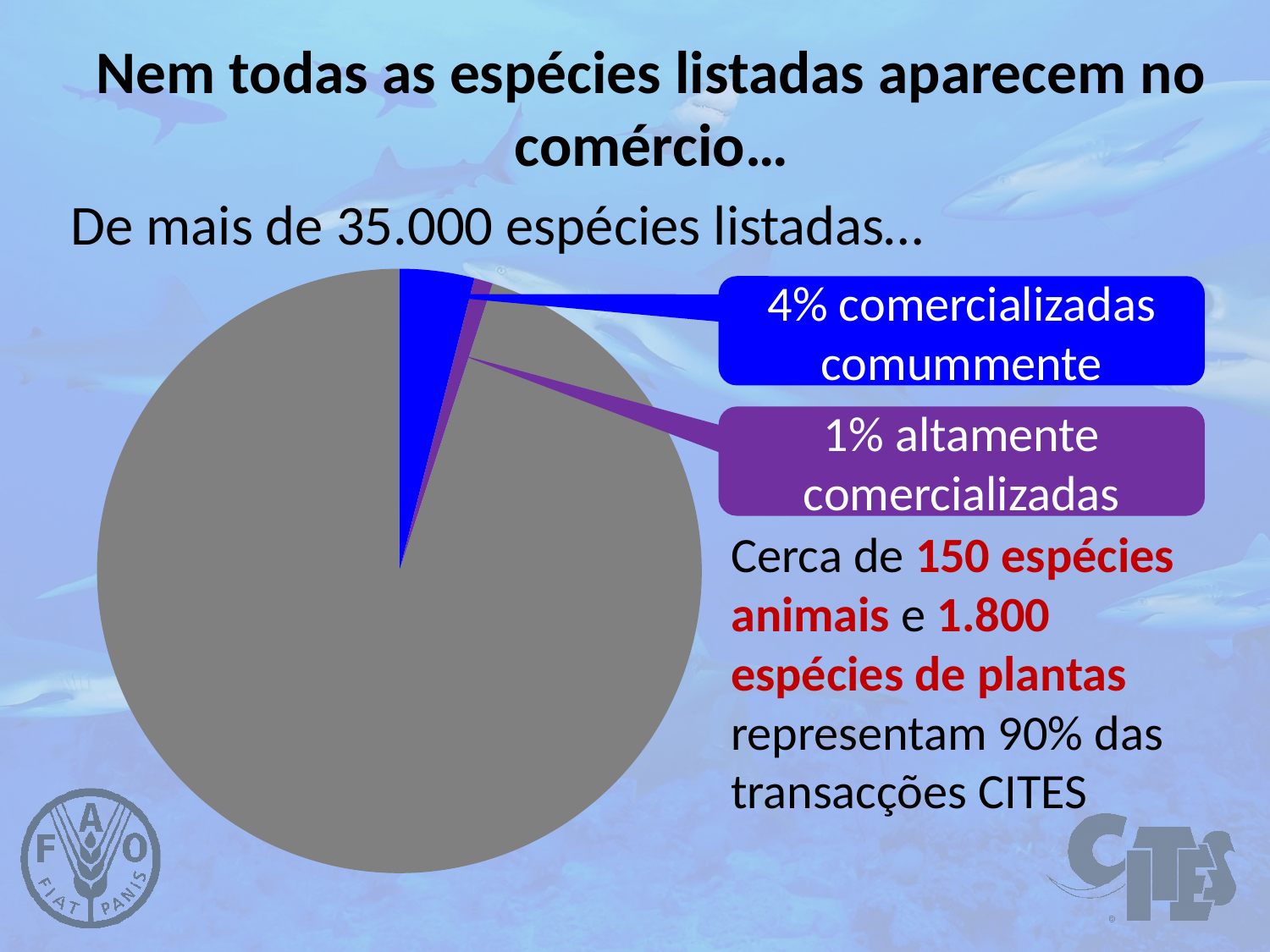
What colour is the slice labelled "1% altamente comercializadas"? purple What share of the pie is labelled "comercializadas comummente"? 4% What is the combined share of the two labelled slices ("comercializadas comummente" and "altamente comercializadas")? 5% What is the difference between the "comercializadas comummente" share and the "altamente comercializadas" share? 3 percentage points What share of the pie is labelled "altamente comercializadas"? 1% Which labelled slice of the pie chart is the smallest? 1% altamente comercializadas What colour is the slice labelled "4% comercializadas comummente"? blue What kind of chart is shown on the slide? pie chart Which slice of the pie chart is the largest? the grey slice Which is larger: the share for "comercializadas comummente" or the share for "altamente comercializadas"? comercializadas comummente How many slices does the pie chart have? 3